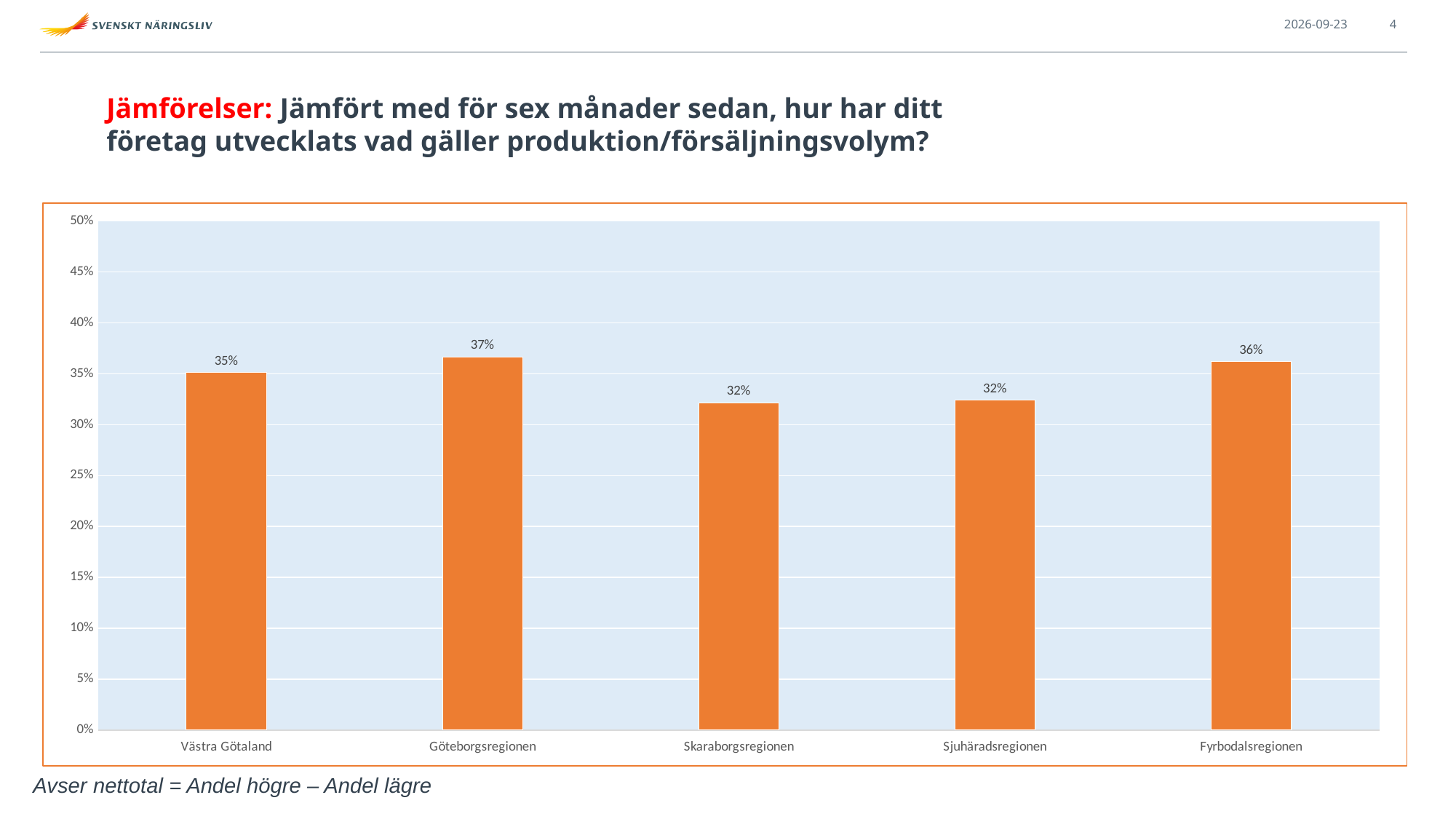
Which region has the highest value? Göteborgsregionen What is the value for Skaraborgsregionen? 32% How many regions are shown in the chart? 5 Is the value for Skaraborgsregionen greater or less than 35%? less Is the value for Göteborgsregionen greater or less than 30%? greater What is the value for Göteborgsregionen? 37% What is the value for Västra Götaland? 35% Which is larger, the value for Västra Götaland or the value for Fyrbodalsregionen? Fyrbodalsregionen What does the note below the chart say the values represent? Nettotal = Andel högre – Andel lägre What kind of chart is shown on the slide? Bar chart What is the difference between the values for Göteborgsregionen and Sjuhäradsregionen? 5 percentage points What is the value for Fyrbodalsregionen? 36%